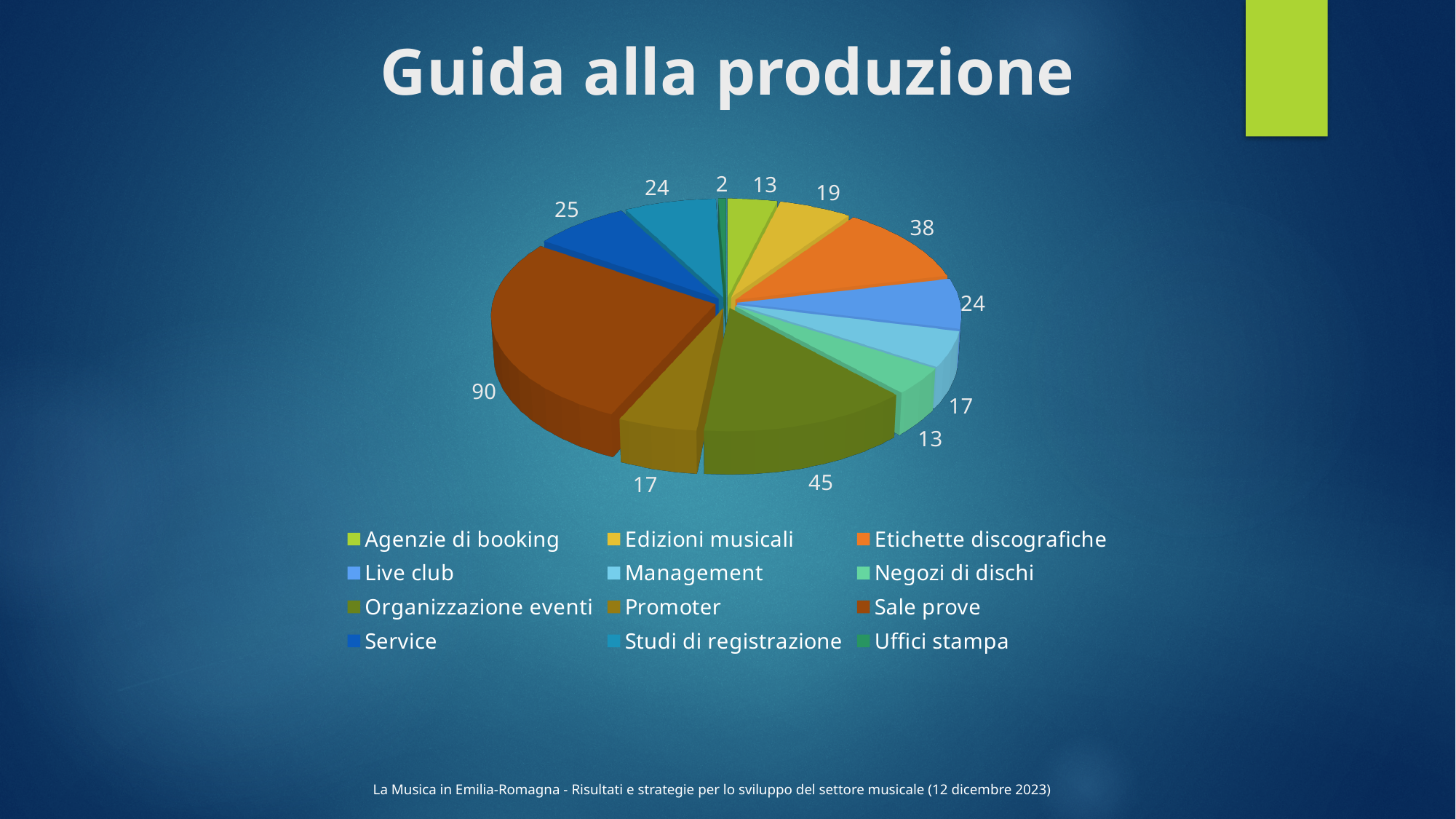
What is the value for Sale prove? 90 What is the value for Uffici stampa? 2 What is the difference between the values for Service and Studi di registrazione? 1 What is the value for Organizzazione eventi? 45 Which is larger, Etichette discografiche or Live club? Etichette discografiche What is the difference between the values for Sale prove and Organizzazione eventi? 45 Which category has the smallest slice? Uffici stampa What is the title of the slide? Guida alla produzione What is the value for Etichette discografiche? 38 How many categories does the pie chart show? 12 Which category has the largest slice? Sale prove What kind of chart is shown on the slide? Pie chart